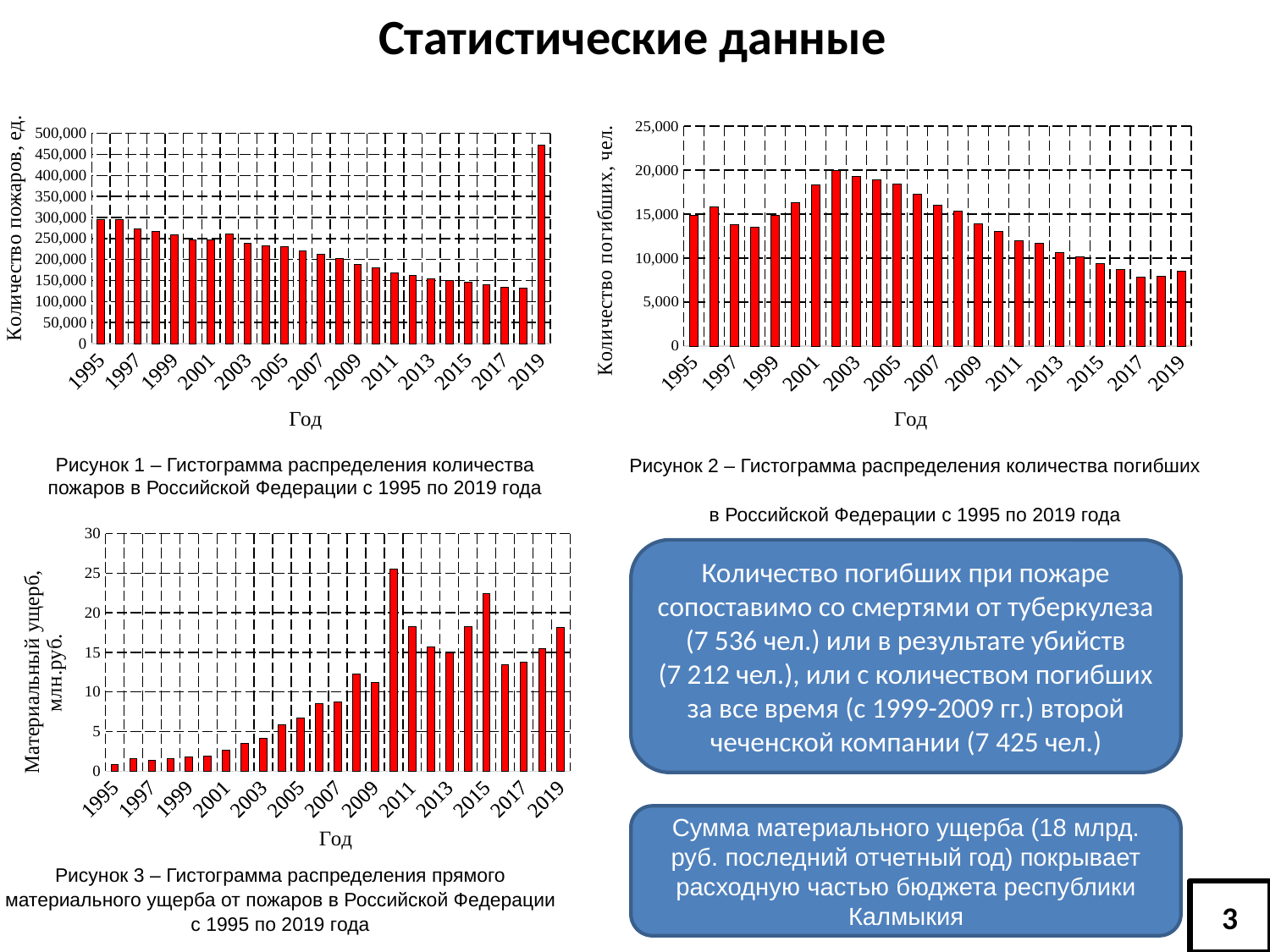
In Рисунок 2 (top-right chart), do the values generally rise or fall from 2003 to 2019? fall In Рисунок 3 (bottom-left chart), is the value for 1995 greater or less than 5? less In Рисунок 1 (top-left chart), is the value for 2010 greater or less than 200,000? less In Рисунок 1 (top-left chart), which year has the highest number of fires? 2019 In Рисунок 3 (bottom-left chart), which is larger, the value for 2015 or the value for 2016? 2015 In Рисунок 2 (top-right chart), which year has the highest number of deaths? 2002 What type of chart is Рисунок 1 (top-left chart)? bar chart In Рисунок 2 (top-right chart), is the value for 2019 greater or less than 10,000? less In Рисунок 3 (bottom-left chart), which year has the highest material damage? 2010 In Рисунок 2 (top-right chart), which is larger, the value for 2001 or the value for 2011? 2001 In Рисунок 1 (top-left chart), how many bars (years) are plotted? 25